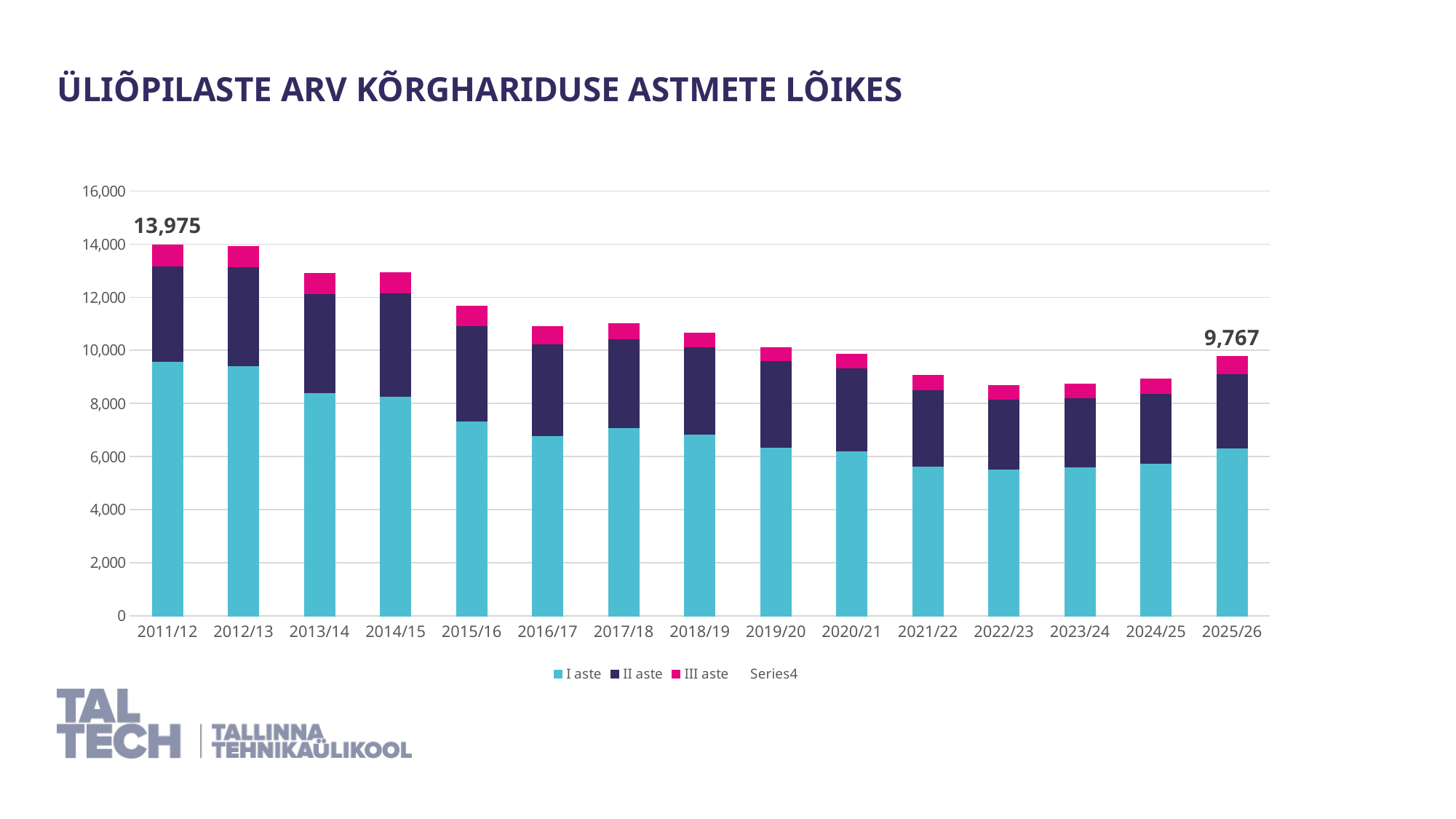
Which academic year has the highest total bar? 2011/12 What kind of chart is shown on the slide? Stacked bar chart What is the total number of students shown for 2025/26? 9,767 How many academic years (categories) are shown on the x axis? 15 What is the difference between the total for 2011/12 and the total for 2025/26? 4,208 Do the total bar heights generally rise or fall from 2011/12 to 2025/26? Fall Is the total bar for 2015/16 greater or less than 12,000? less Is the I aste value for 2011/12 greater or less than 8,000? greater Which total is larger, 2011/12 or 2025/26? 2011/12 What is the total number of students shown for 2011/12? 13,975 What is the title of the chart? ÜLIÕPILASTE ARV KÕRGHARIDUSE ASTMETE LÕIKES How many entries does the legend list? 4